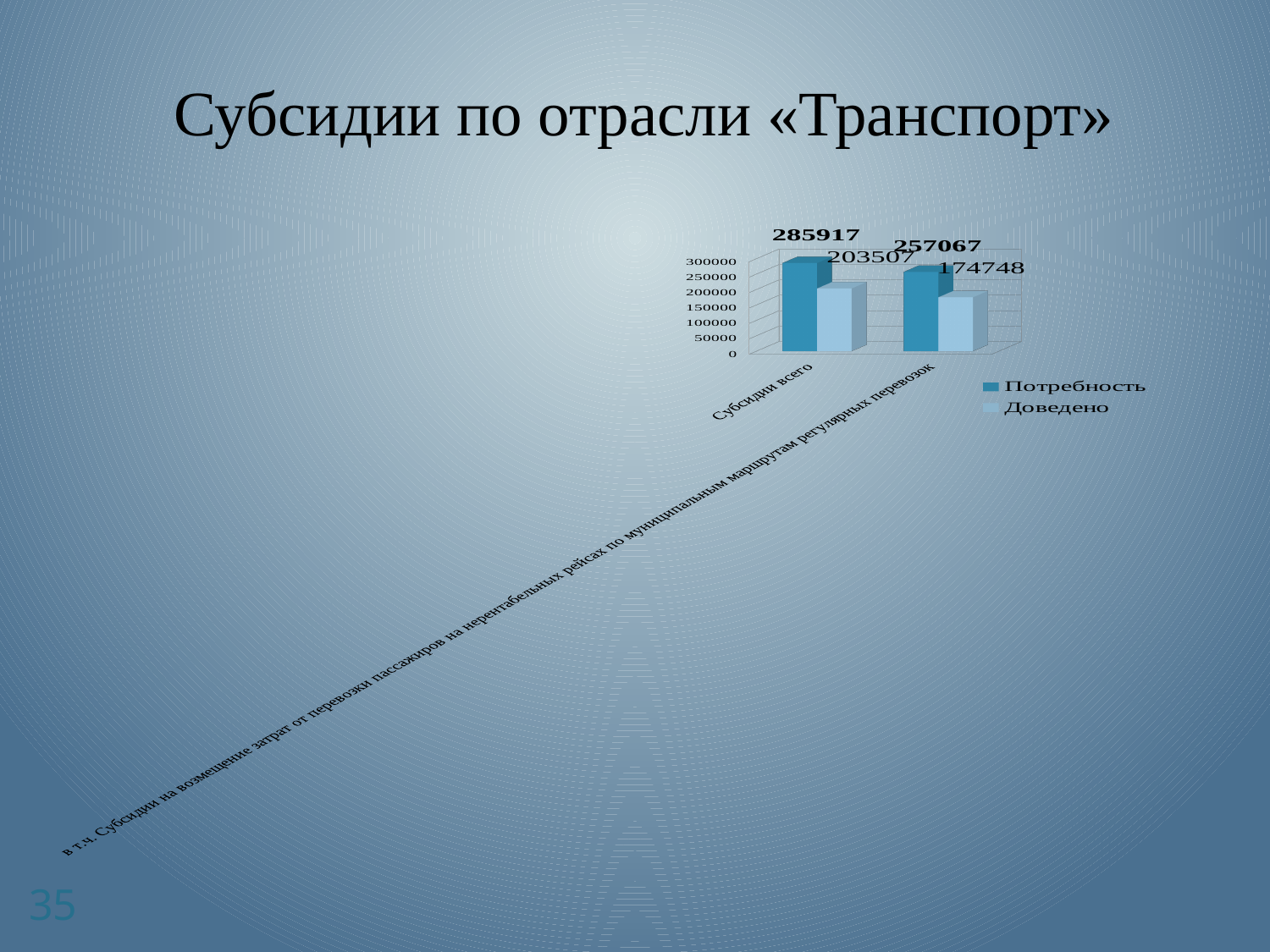
How many series does the chart legend list? 2 What kind of chart is shown on the slide? bar chart Is the Доведено value for Субсидии всего greater or less than 250000? less Which bar in the chart has the highest value? Потребность for Субсидии всего What is the value of Доведено for the category 'в т.ч. Субсидии на возмещение затрат от перевозки пассажиров на нерентабельных рейсах по муниципальным маршрутам регулярных перевозок'? 174748 Which is larger for Субсидии всего: Потребность or Доведено? Потребность Which bar in the chart has the lowest value? Доведено for в т.ч. Субсидии на возмещение затрат от перевозки пассажиров на нерентабельных рейсах по муниципальным маршрутам регулярных перевозок What is the difference between Потребность and Доведено for Субсидии всего? 82410 What is the value of Доведено for Субсидии всего? 203507 What is the value of Потребность for the category 'в т.ч. Субсидии на возмещение затрат от перевозки пассажиров на нерентабельных рейсах по муниципальным маршрутам регулярных перевозок'? 257067 What is the value of Потребность for Субсидии всего? 285917 How many categories are shown on the chart's x axis? 2